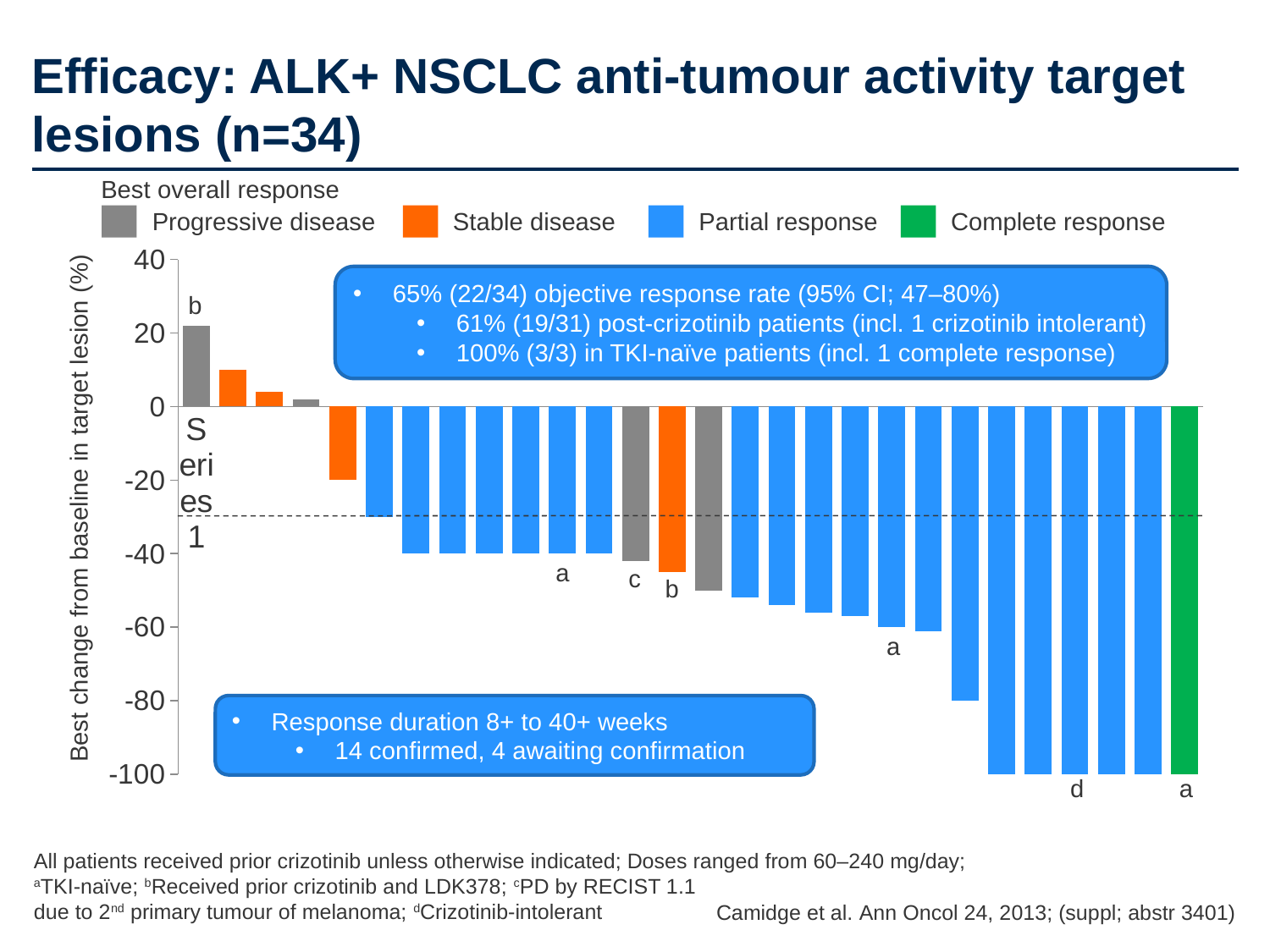
How many response categories does the legend list? 4 What is the value of the green Complete response bar? -100 How many green Complete response bars are plotted? 1 Which response category does the highest bar belong to? Progressive disease Is the value for the leftmost bar labelled 'b' greater or less than 0? greater Is the value for the bar labelled 'c' greater or less than -20? less How many orange Stable disease bars are plotted? 4 What is the title of the y axis? Best change from baseline in target lesion (%) Which is larger, the first bar or the second bar from the left? the first bar Is the value for the bar labelled 'd' greater or less than -80? less What kind of chart is shown on the slide? bar chart Which colour represents Complete response in the legend? green